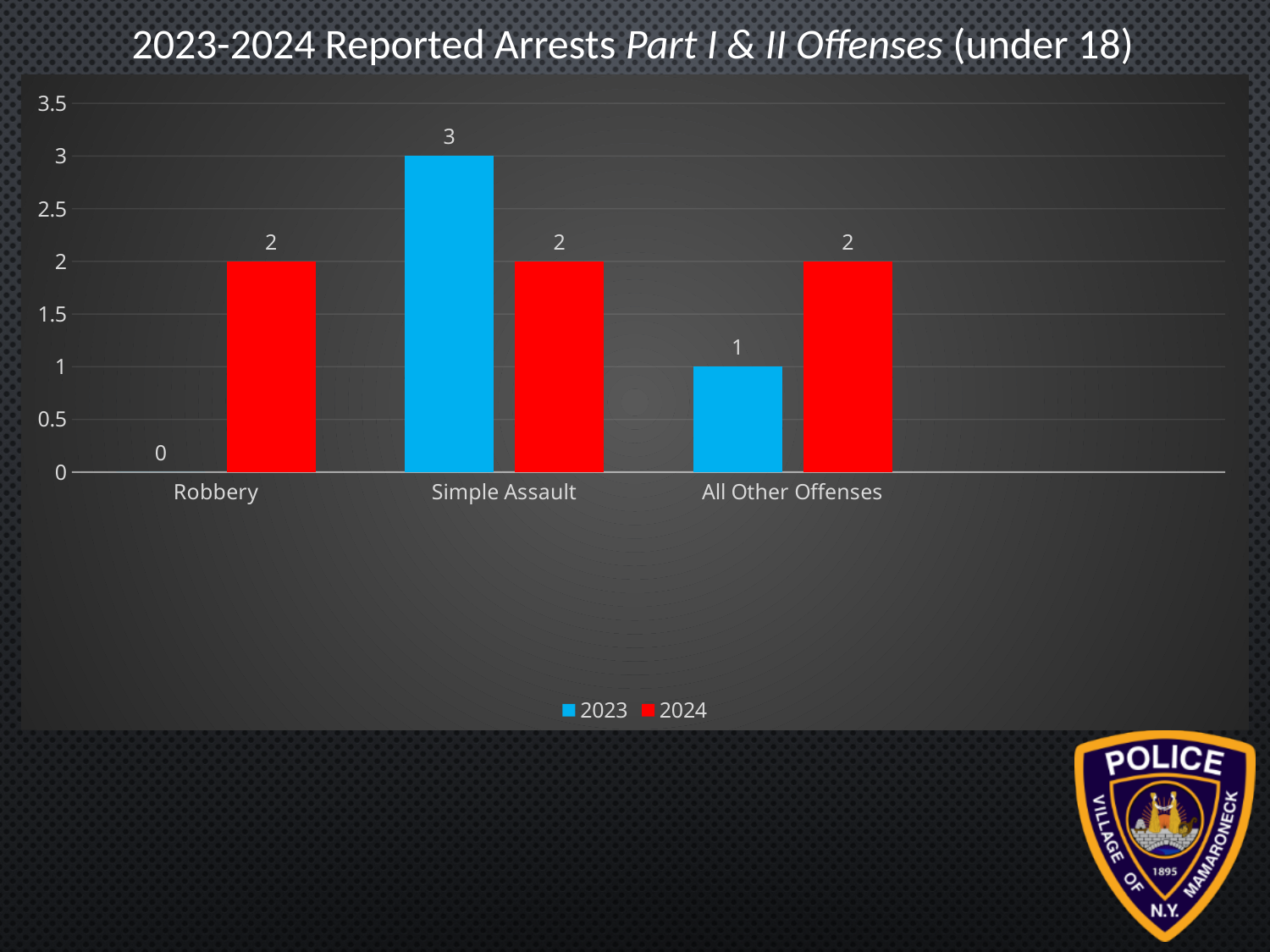
What is the 2023 value for Robbery? 0 What is the 2024 value for All Other Offenses? 2 What is the 2023 value for All Other Offenses? 1 Which category has the highest 2023 value? Simple Assault How many series does the legend list? 2 What is the 2023 value for Simple Assault? 3 Which is larger for All Other Offenses, the 2023 value or the 2024 value? 2024 What is the 2024 value for Robbery? 2 Which category has the lowest 2023 value? Robbery What is the difference between the 2023 and 2024 values for Simple Assault? 1 What kind of chart is shown on the slide? Bar chart How many categories are shown on the x axis? 3